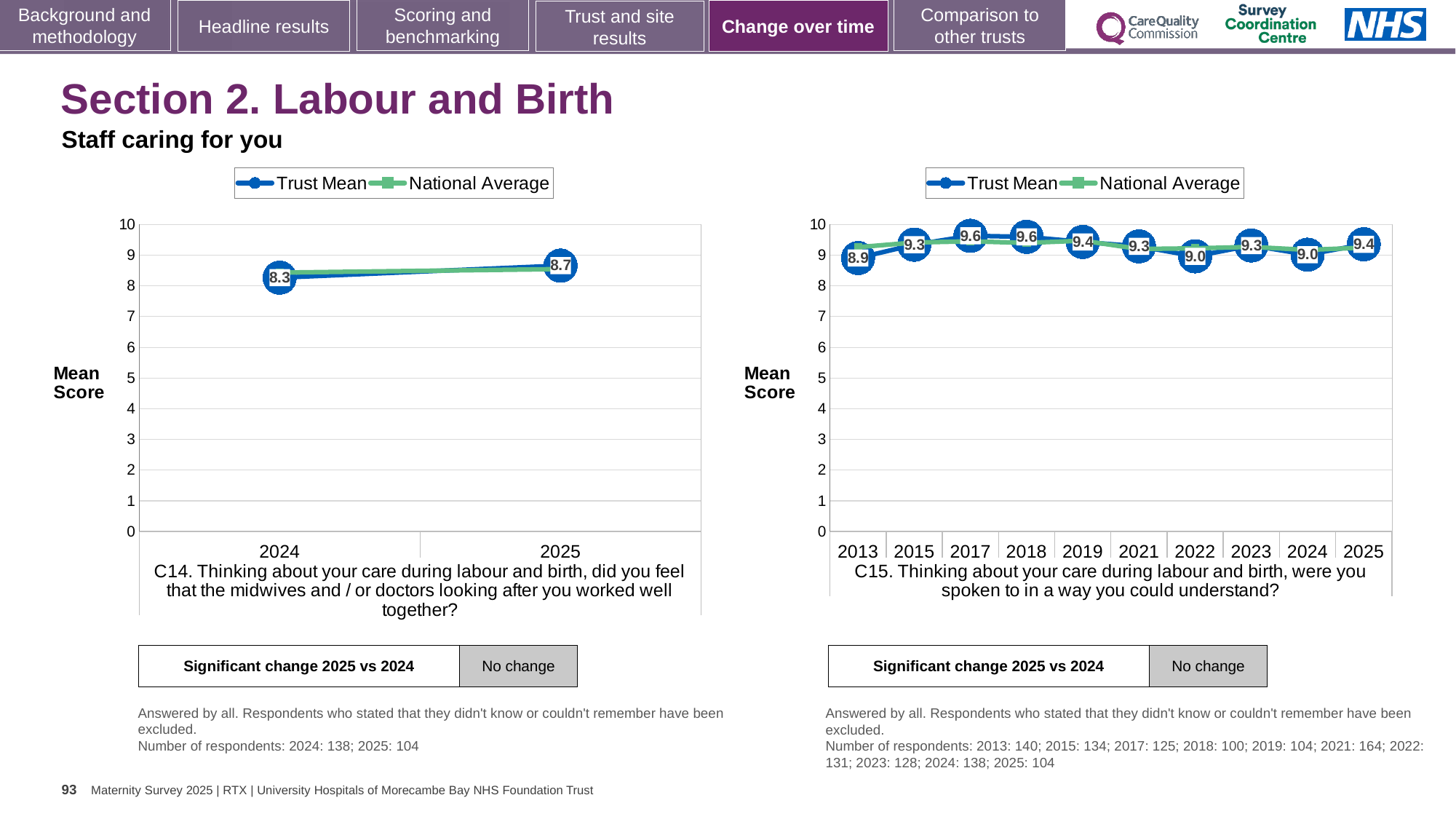
In the right chart (C15), how many years are shown on the x axis? 10 What type of chart is used on the right side of the slide? line chart In the left chart (C14), does the Trust Mean rise or fall from 2024 to 2025? rise In the right chart (C15), is the Trust Mean for 2022 greater or less than 8? greater In the right chart (C15), which year has the lowest Trust Mean score? 2013 In the left chart (C14), what is the Trust Mean score for 2025? 8.7 In the right chart (C15), what is the Trust Mean score for 2025? 9.4 In the left chart (C14), by how much did the Trust Mean change from 2024 to 2025? 0.4 In the right chart (C15), what is the Trust Mean score for 2013? 8.9 In the left chart (C14), what is the Trust Mean score for 2024? 8.3 In the right chart (C15), what is the difference between the Trust Mean in 2017 and in 2013? 0.7 How many series does the legend of the left chart list? 2